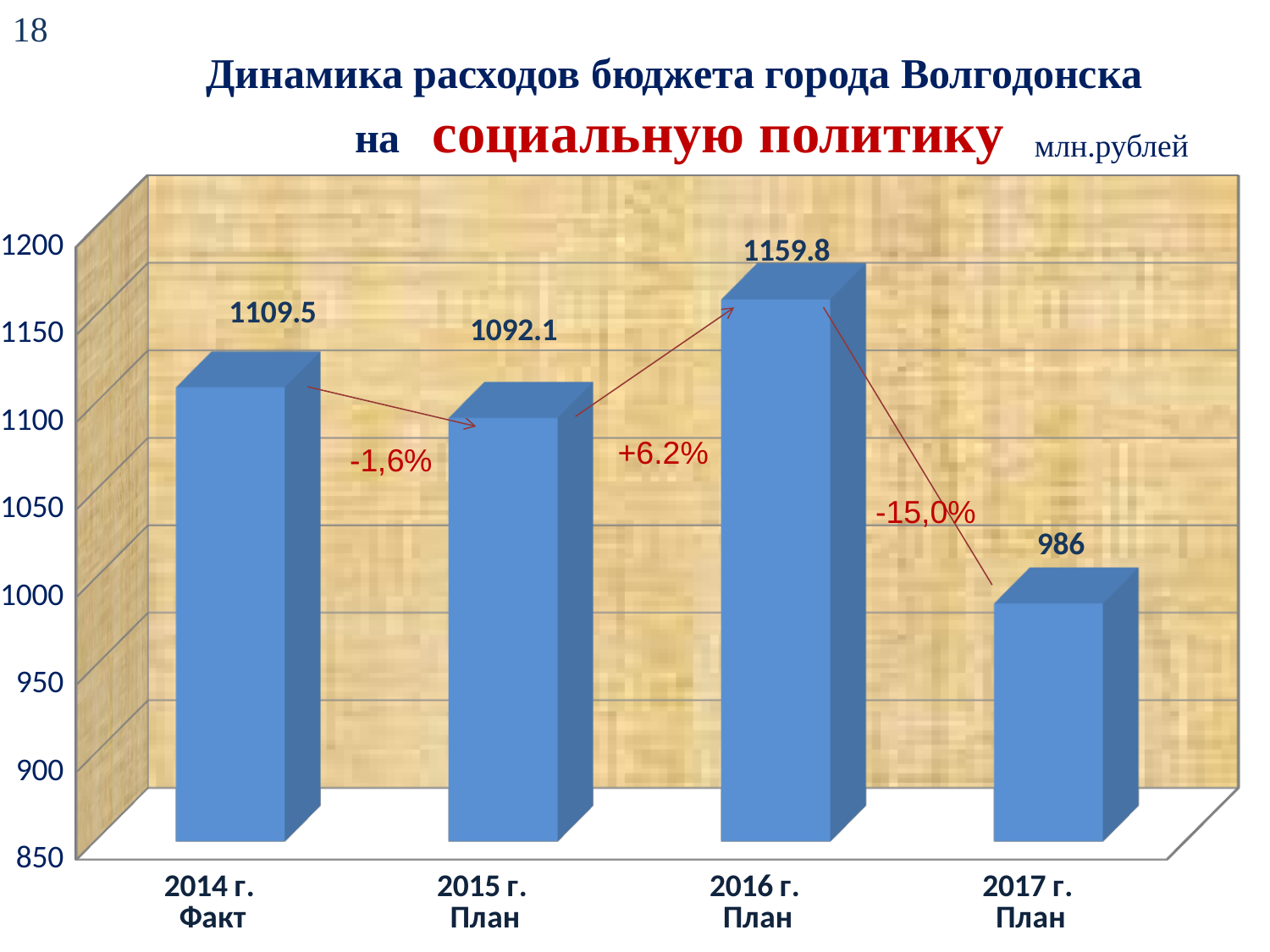
What is the value for 2014 г. Факт? 1109.5 What is the value for 2016 г. План? 1159.8 Which category has the highest value? 2016 г. План Which category has the lowest value? 2017 г. План What percentage change is shown between 2016 г. План and 2017 г. План? -15,0% Which is larger, the value for 2014 г. Факт or the value for 2015 г. План? 2014 г. Факт What kind of chart is this? bar chart How many categories are shown on the x axis? 4 What is the difference between the values for 2016 г. План and 2017 г. План? 173.8 What is the value for 2017 г. План? 986 What is the difference between the values for 2014 г. Факт and 2015 г. План? 17.4 What is the value for 2015 г. План? 1092.1